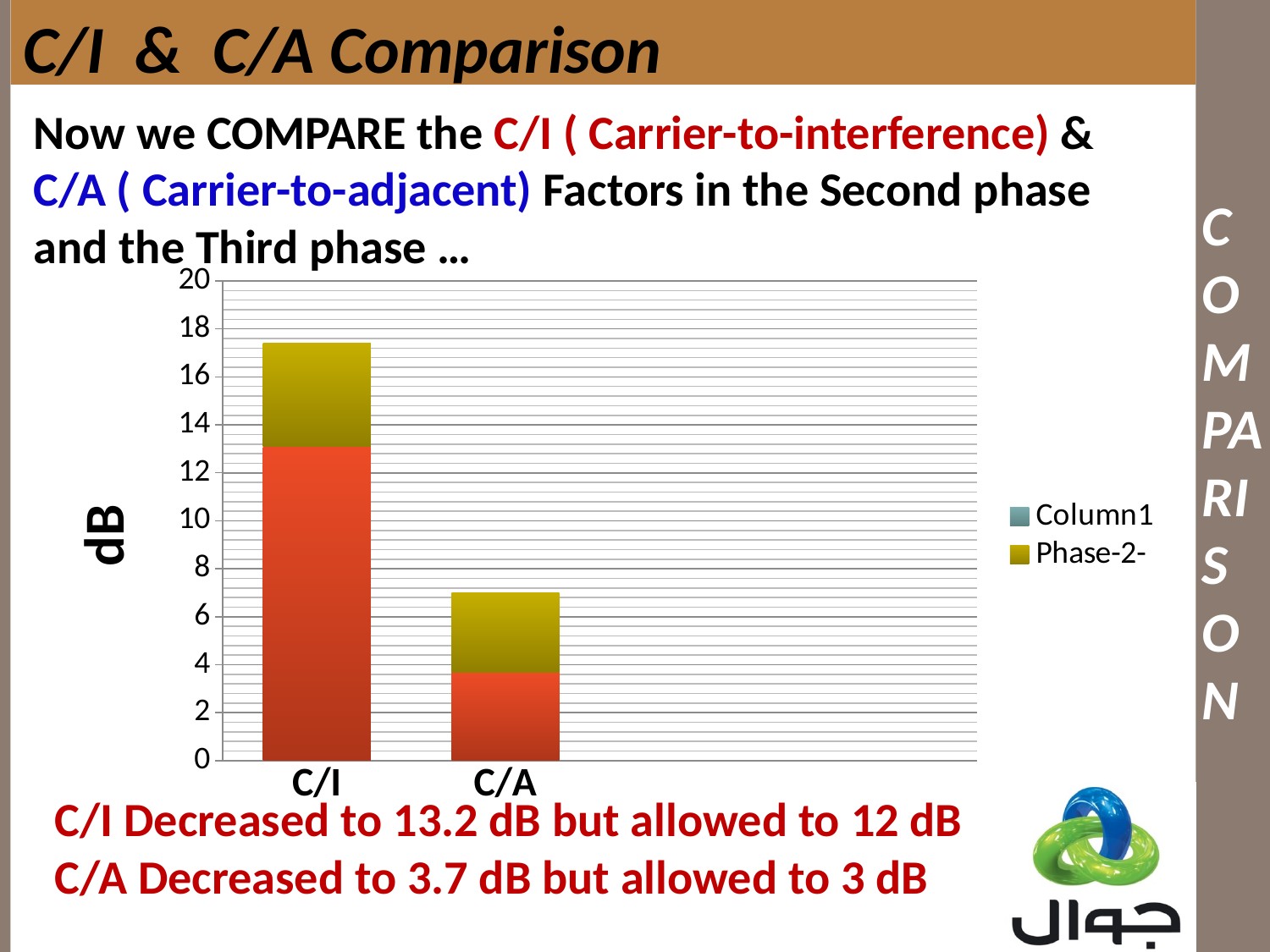
How many series does the chart legend list? 2 How many categories are shown on the x axis of the chart? 2 What kind of chart is shown on the slide? bar chart Is the total height of the C/A stacked bar greater or less than 8? less What is the label on the vertical axis of the chart? dB Do the bar heights rise or fall moving from C/I to C/A along the x axis? fall Which category has the shorter stacked bar? C/A What are the two entries listed in the chart legend? Column1 and Phase-2- Is the total height of the C/I stacked bar greater or less than 16? greater Which category has the taller stacked bar, C/I or C/A? C/I